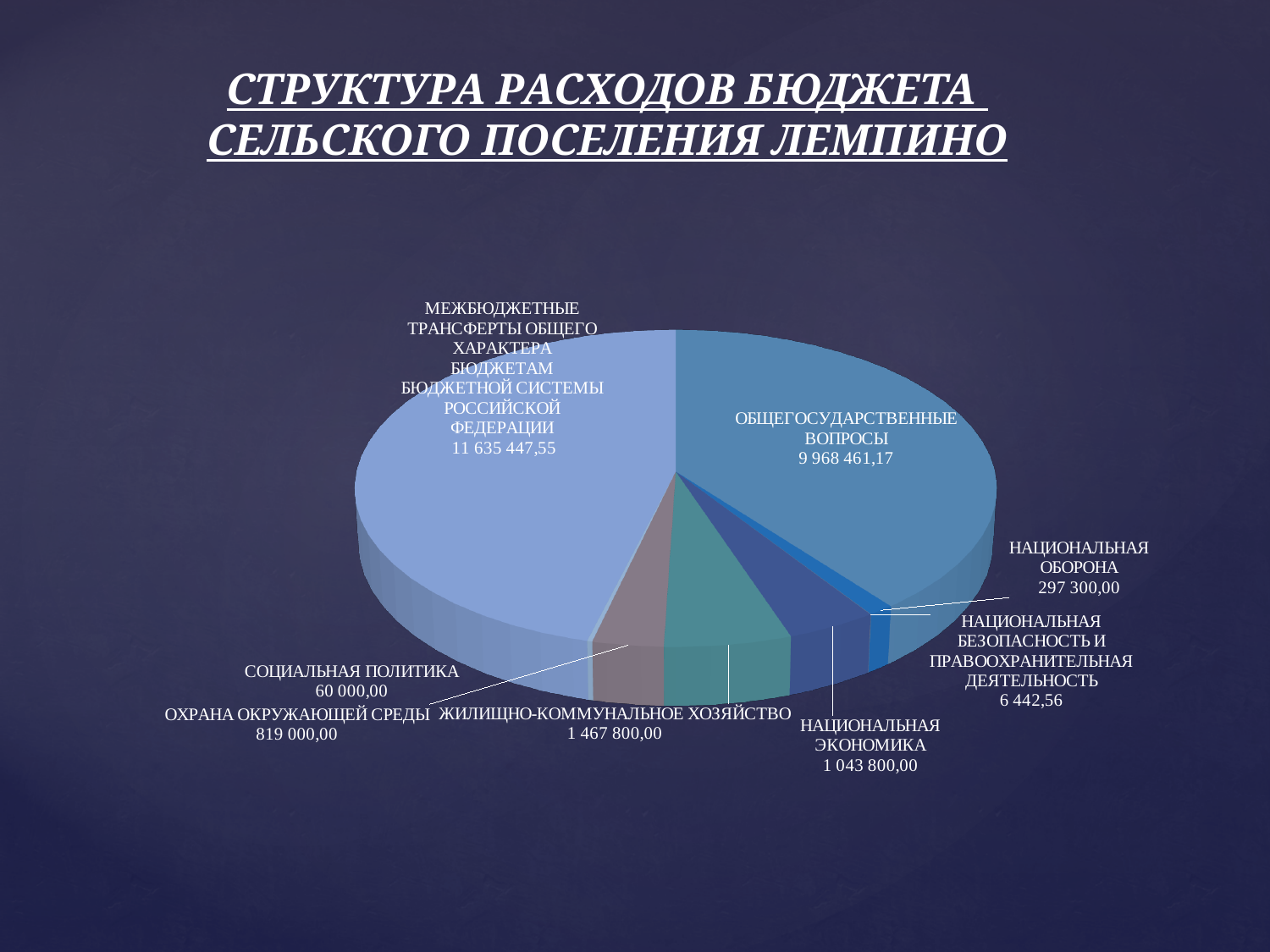
What is the value for ЖИЛИЩНО-КОММУНАЛЬНОЕ ХОЗЯЙСТВО? 1 467 800,00 What is the value for ОБЩЕГОСУДАРСТВЕННЫЕ ВОПРОСЫ? 9 968 461,17 What is the value for СОЦИАЛЬНАЯ ПОЛИТИКА? 60 000,00 What kind of chart is shown on the slide? Pie chart Which is larger: ОХРАНА ОКРУЖАЮЩЕЙ СРЕДЫ or НАЦИОНАЛЬНАЯ ЭКОНОМИКА? НАЦИОНАЛЬНАЯ ЭКОНОМИКА What is the title of the chart on the slide? СТРУКТУРА РАСХОДОВ БЮДЖЕТА СЕЛЬСКОГО ПОСЕЛЕНИЯ ЛЕМПИНО Which category has the smallest value in the pie chart? НАЦИОНАЛЬНАЯ БЕЗОПАСНОСТЬ И ПРАВООХРАНИТЕЛЬНАЯ ДЕЯТЕЛЬНОСТЬ What is the difference between the values for ЖИЛИЩНО-КОММУНАЛЬНОЕ ХОЗЯЙСТВО and НАЦИОНАЛЬНАЯ ЭКОНОМИКА? 424 000,00 What is the difference between the values for МЕЖБЮДЖЕТНЫЕ ТРАНСФЕРТЫ ОБЩЕГО ХАРАКТЕРА БЮДЖЕТАМ БЮДЖЕТНОЙ СИСТЕМЫ РОССИЙСКОЙ ФЕДЕРАЦИИ and ОБЩЕГОСУДАРСТВЕННЫЕ ВОПРОСЫ? 1 666 986,38 How many categories (slices) does the pie chart have? 8 Which category has the largest value in the pie chart? МЕЖБЮДЖЕТНЫЕ ТРАНСФЕРТЫ ОБЩЕГО ХАРАКТЕРА БЮДЖЕТАМ БЮДЖЕТНОЙ СИСТЕМЫ РОССИЙСКОЙ ФЕДЕРАЦИИ What is the value for НАЦИОНАЛЬНАЯ ОБОРОНА? 297 300,00